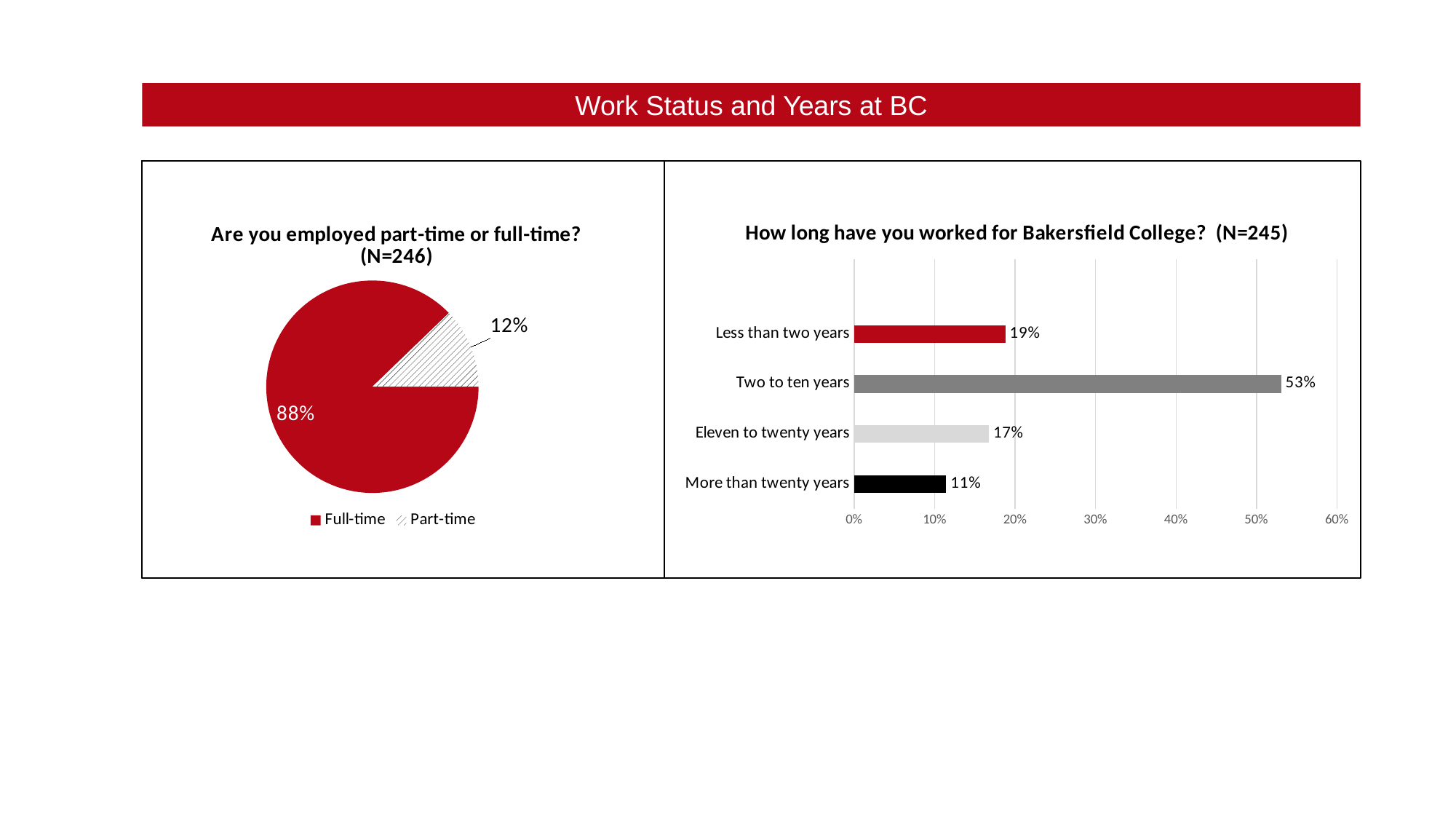
In the bar chart on the right, which category has the lowest value? More than twenty years What kind of chart is the chart on the right? Bar chart In the bar chart on the right, which category has the highest value? Two to ten years How many entries does the legend of the pie chart on the left list? 2 How many categories are shown in the bar chart on the right? 4 In the bar chart on the right, what percentage of respondents have worked for Bakersfield College for two to ten years? 53% In the bar chart on the right, what is the difference between the values for Less than two years and Eleven to twenty years? 2% In the pie chart on the left, what percentage of respondents are employed full-time? 88% In the bar chart on the right, what percentage of respondents have worked for Bakersfield College for more than twenty years? 11% What kind of chart is the chart on the left? Pie chart In the pie chart on the left, what percentage of respondents are employed part-time? 12% In the pie chart on the left, which category has the larger share, Full-time or Part-time? Full-time